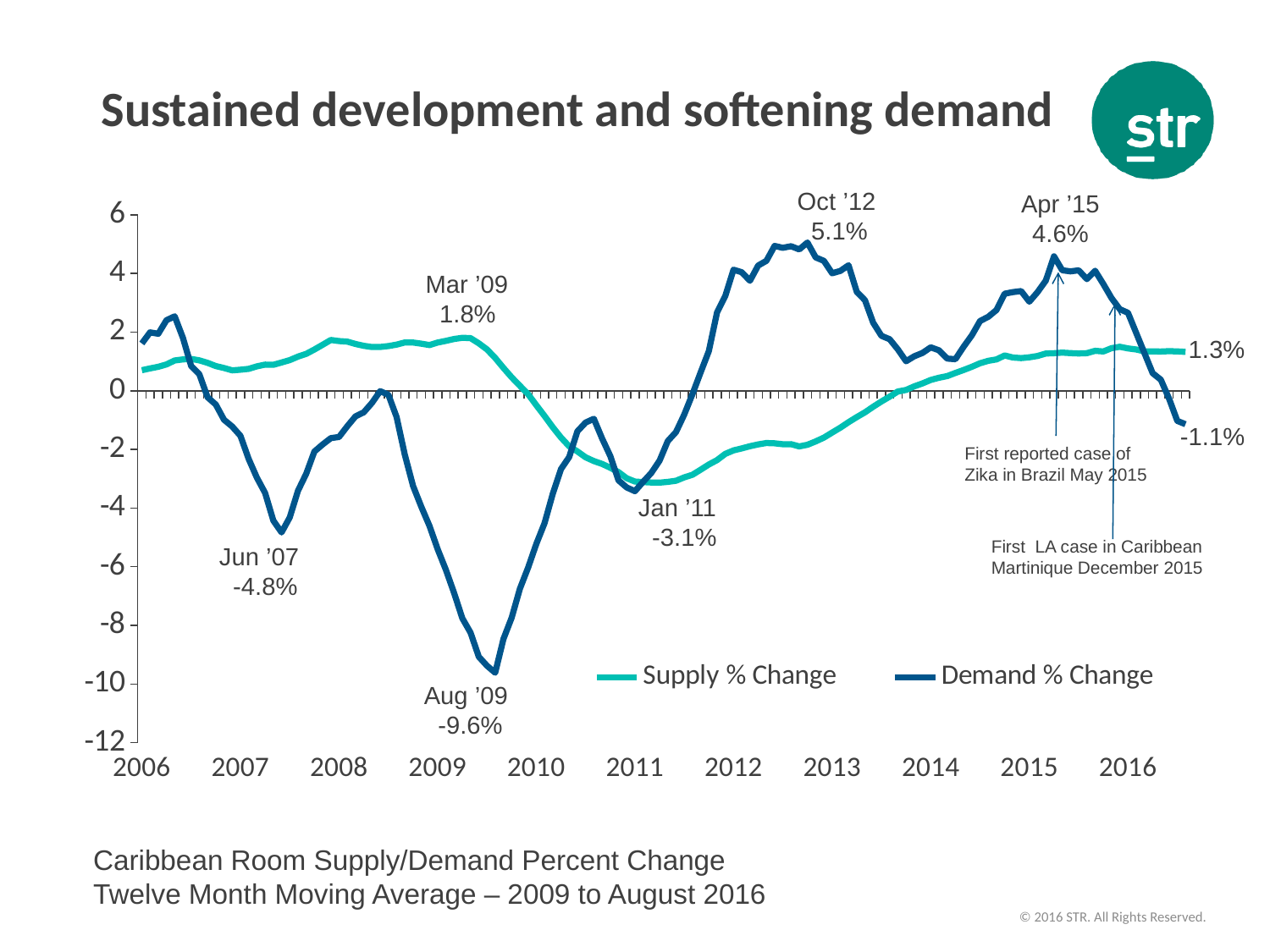
What was the Demand % Change value labelled at Jun '07? -4.8% What kind of chart is shown on the slide? line chart What was the Demand % Change value labelled at Oct '12? 5.1% What was the Demand % Change value labelled at Aug '09? -9.6% What is the final labelled value of the Demand % Change line at the right end of the chart? -1.1% How many series does the legend list? 2 Which labelled point on the Demand % Change line has the lowest value? Aug '09 What was the Demand % Change value labelled at Apr '15? 4.6% What is the difference between the Demand % Change peaks at Oct '12 (5.1%) and Apr '15 (4.6%)? 0.5% Which labelled point on the Demand % Change line has the highest value? Oct '12 What is the final labelled value of the Supply % Change line at the right end of the chart? 1.3% Which series is drawn in dark blue according to the legend? Demand % Change